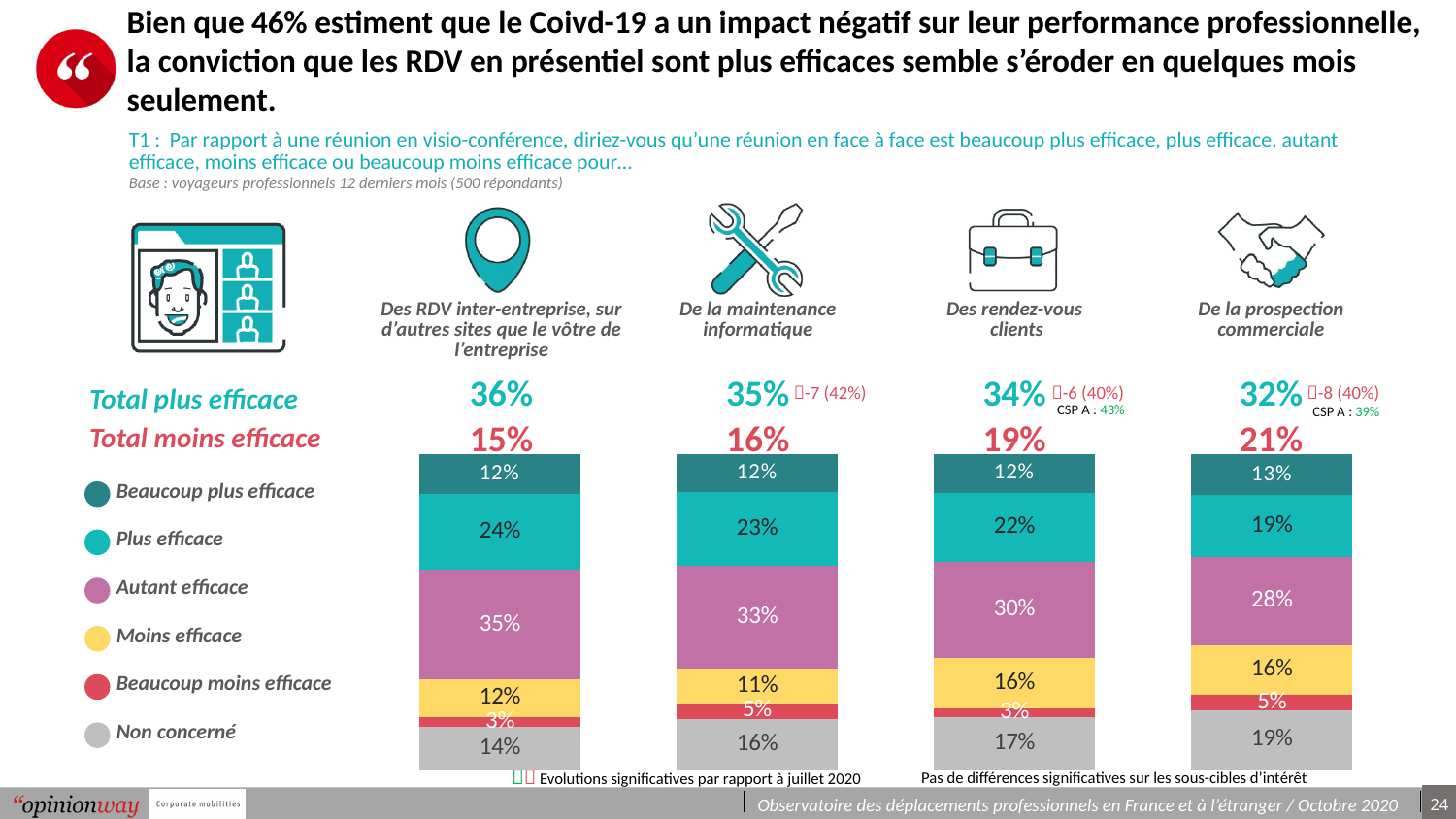
Which category has the lowest "Autant efficace" value? De la prospection commerciale Which is larger: the "Non concerné" value for "Des rendez-vous clients" or for "De la maintenance informatique"? Des rendez-vous clients What is the value of "Autant efficace" for "Des rendez-vous clients"? 30% How many series does the legend list? 6 What is the value of "Plus efficace" for "De la maintenance informatique"? 23% Does the "Total plus efficace" value rise or fall from left to right across the four categories? Fall What colour represents "Moins efficace" in the legend? Yellow What is the difference between the "Autant efficace" values for "Des RDV inter-entreprise" and "De la prospection commerciale"? 7 percentage points What is the "Total plus efficace" value for "De la prospection commerciale"? 32% What kind of chart is shown on the slide? Stacked bar chart How many categories (bars) are plotted? 4 Which category has the highest "Total moins efficace" value? De la prospection commerciale